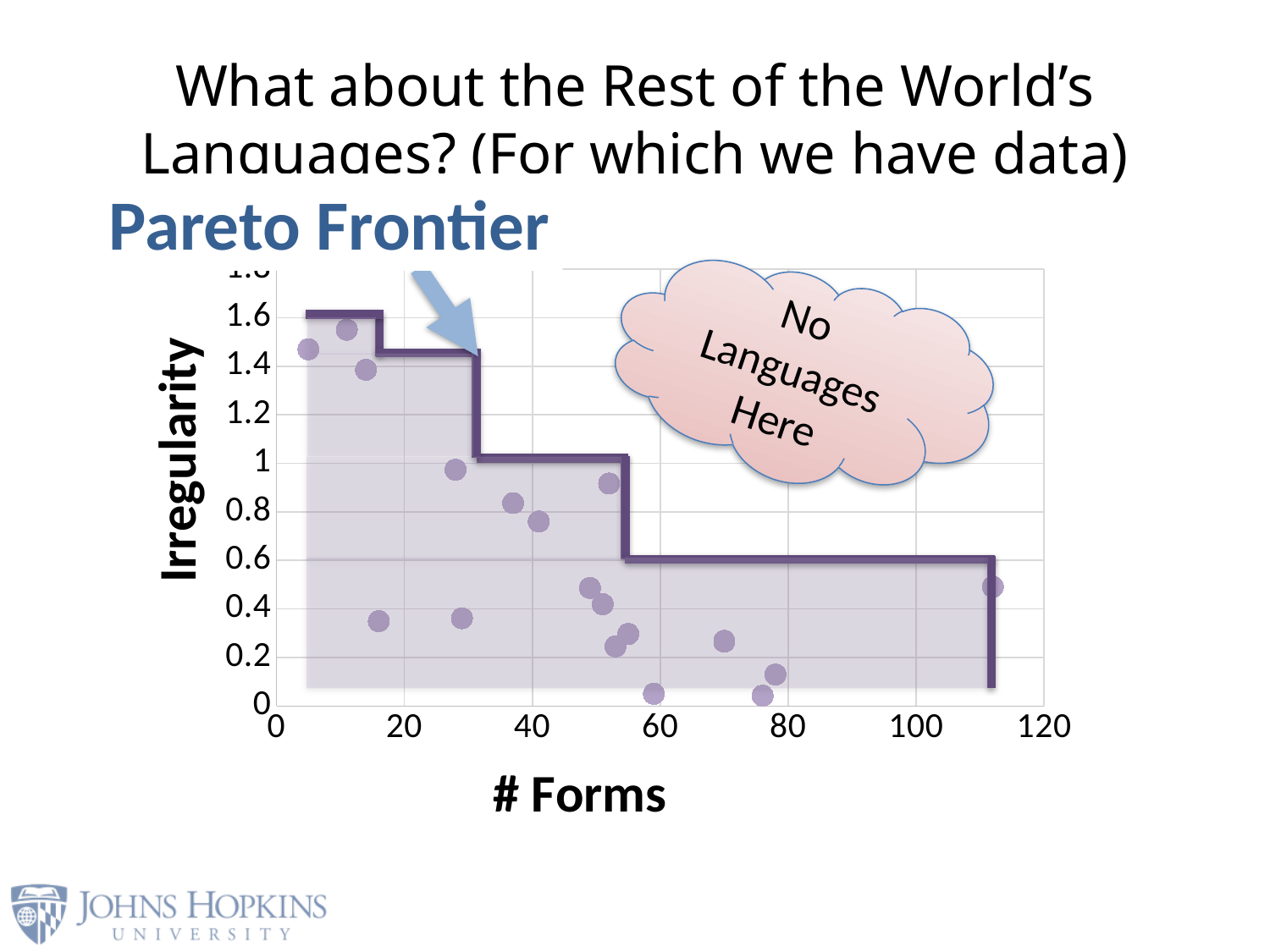
Is the irregularity of the rightmost point (the one with the most forms) greater or less than 0.6? less What is the label of the y axis of the chart? Irregularity Is the irregularity of the lowest point on the chart greater or less than 0.2? less Is the # Forms value of the highest point on the chart greater or less than 20? less Overall, does irregularity rise or fall as the number of forms increases along the x axis? fall What is the largest tick value shown on the x axis? 120 What is the label of the x axis of the chart? # Forms What kind of chart is shown on the slide? scatter plot